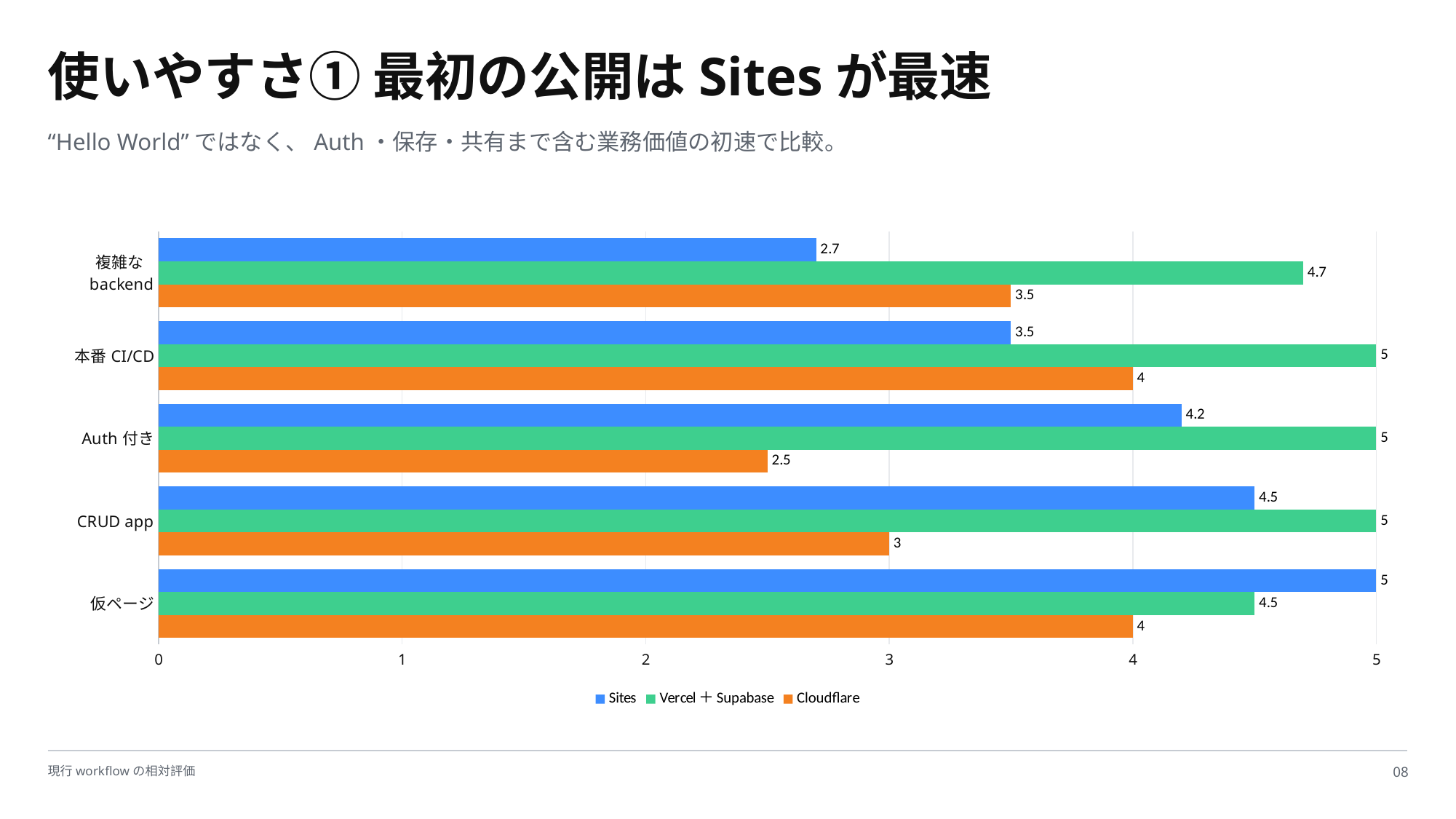
Which category has the lowest value for Sites? 複雑な backend What type of chart is shown on the slide? bar chart What is the value for Sites in the 仮ページ category? 5 Which series is shown in orange in the legend? Cloudflare Is the value for Sites in the 本番 CI/CD category greater or less than 4? less How many categories are shown on the chart? 5 In the CRUD app category, which is larger: the Sites value or the Cloudflare value? Sites How many series does the legend list? 3 What is the value for Vercel + Supabase in the 複雑な backend category? 4.7 What is the value for Cloudflare in the Auth 付き category? 2.5 What is the difference between the Vercel + Supabase value and the Sites value in the 複雑な backend category? 2 Which category has the highest value for Cloudflare? 仮ページ and 本番 CI/CD (tied at 4)